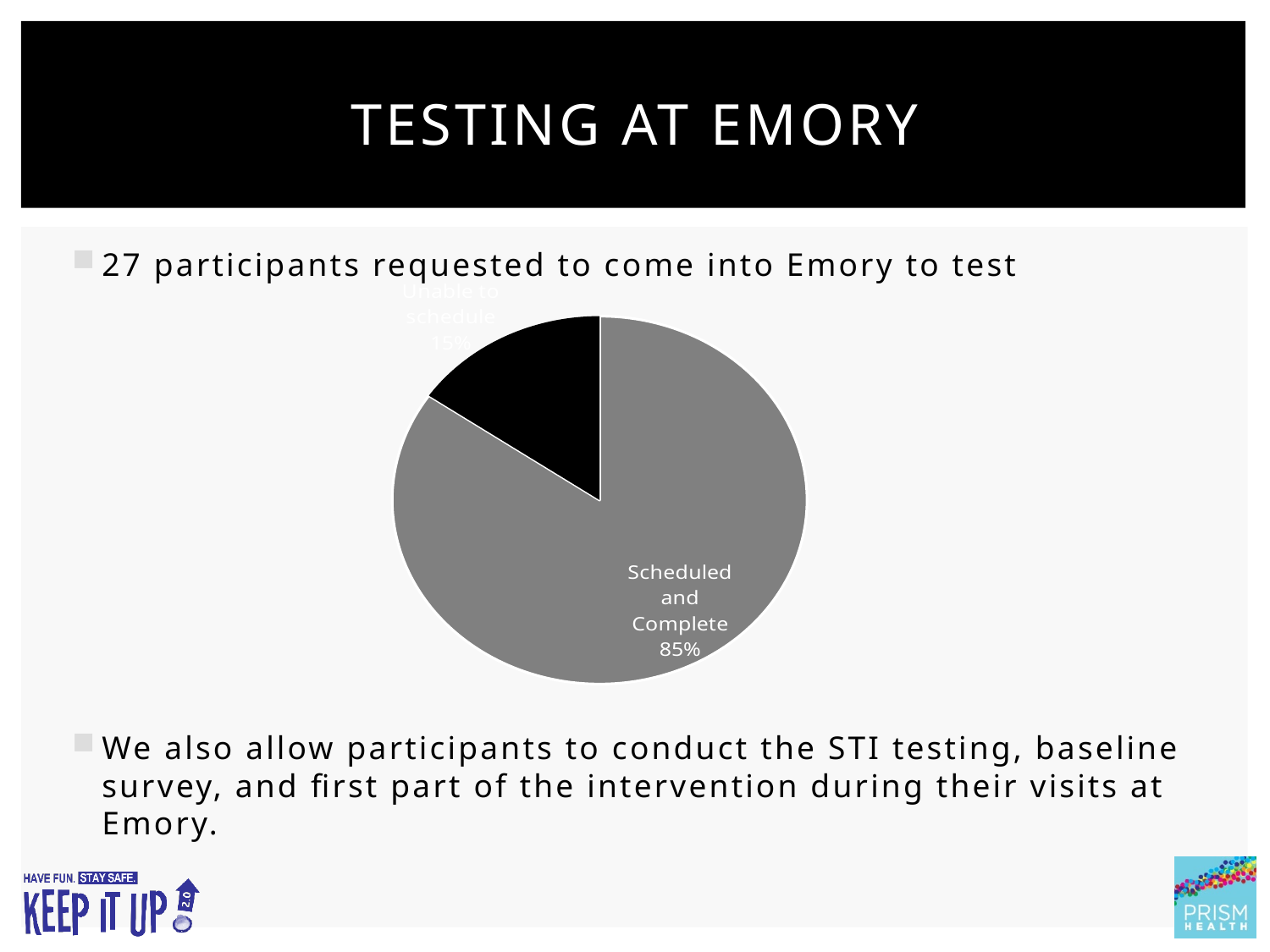
Which is larger: the "Scheduled and Complete" slice or the "Unable to schedule" slice? Scheduled and Complete What share of the pie does the "Scheduled and Complete" slice represent? 85% Which slice of the pie chart is the largest? Scheduled and Complete Which slice of the pie chart is the smallest? Unable to schedule Is the share for "Scheduled and Complete" greater or less than 50%? greater What is the difference in percentage points between the "Scheduled and Complete" slice and the "Unable to schedule" slice? 70 What colour is the "Scheduled and Complete" slice of the pie chart? gray What kind of chart is shown on the slide? pie chart What colour is the "Unable to schedule" slice of the pie chart? black What share of the pie does the "Unable to schedule" slice represent? 15% How many slices does the pie chart have? 2